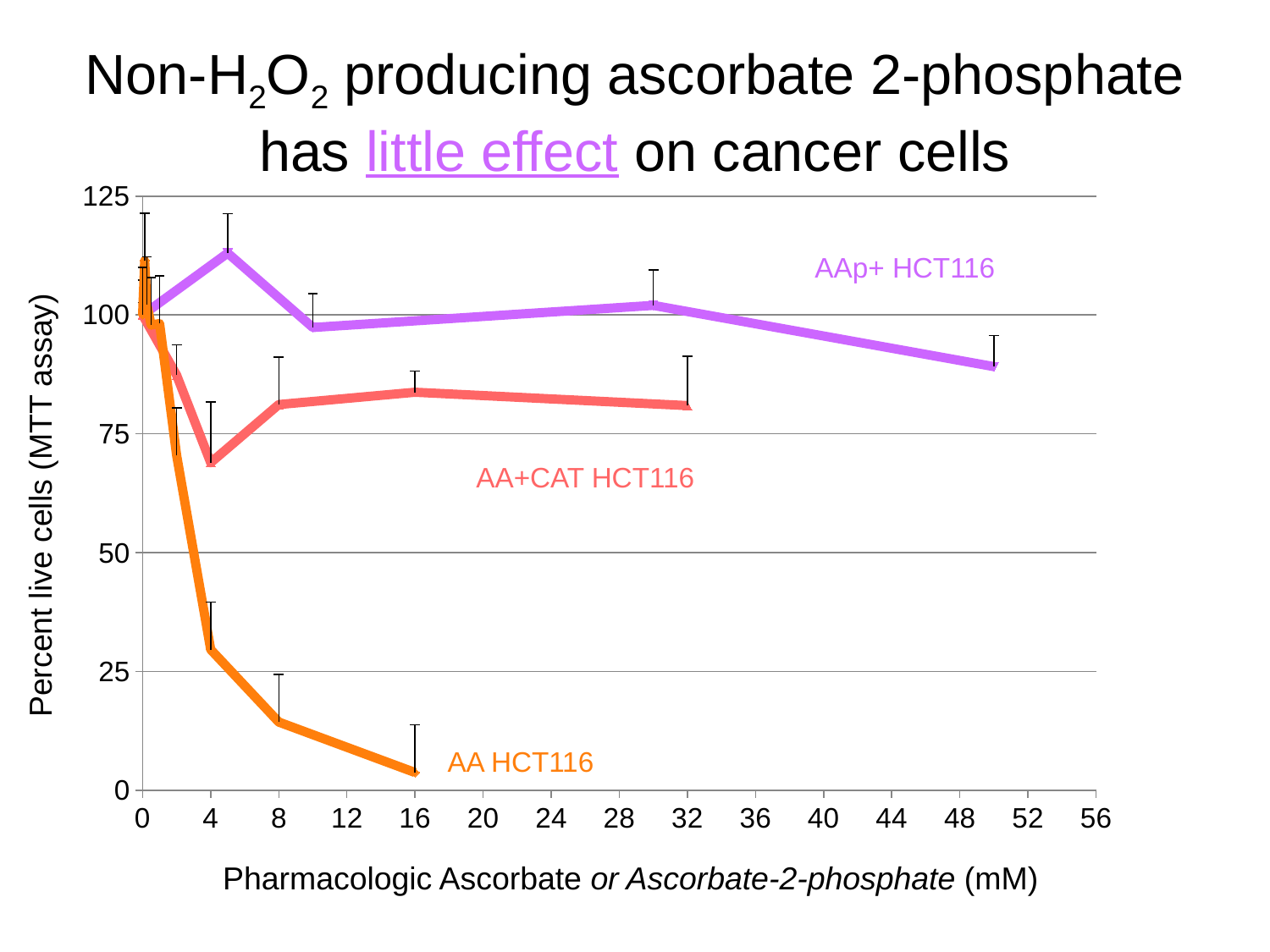
Is the value for AA HCT116 at 8 mM greater or less than 25? less Is the value for AAp+ HCT116 at 5 mM greater or less than 100? greater Is the value for AA HCT116 at 16 mM greater or less than 25? less How many data series are plotted on the chart? 3 Does the AA HCT116 series rise or fall as the concentration increases? fall At 16 mM, which series has the higher percent of live cells: AA+CAT HCT116 or AA HCT116? AA+CAT HCT116 Which series stays highest across the concentration range? AAp+ HCT116 What is the label on the y axis? Percent live cells (MTT assay) What kind of chart is shown on the slide? line chart